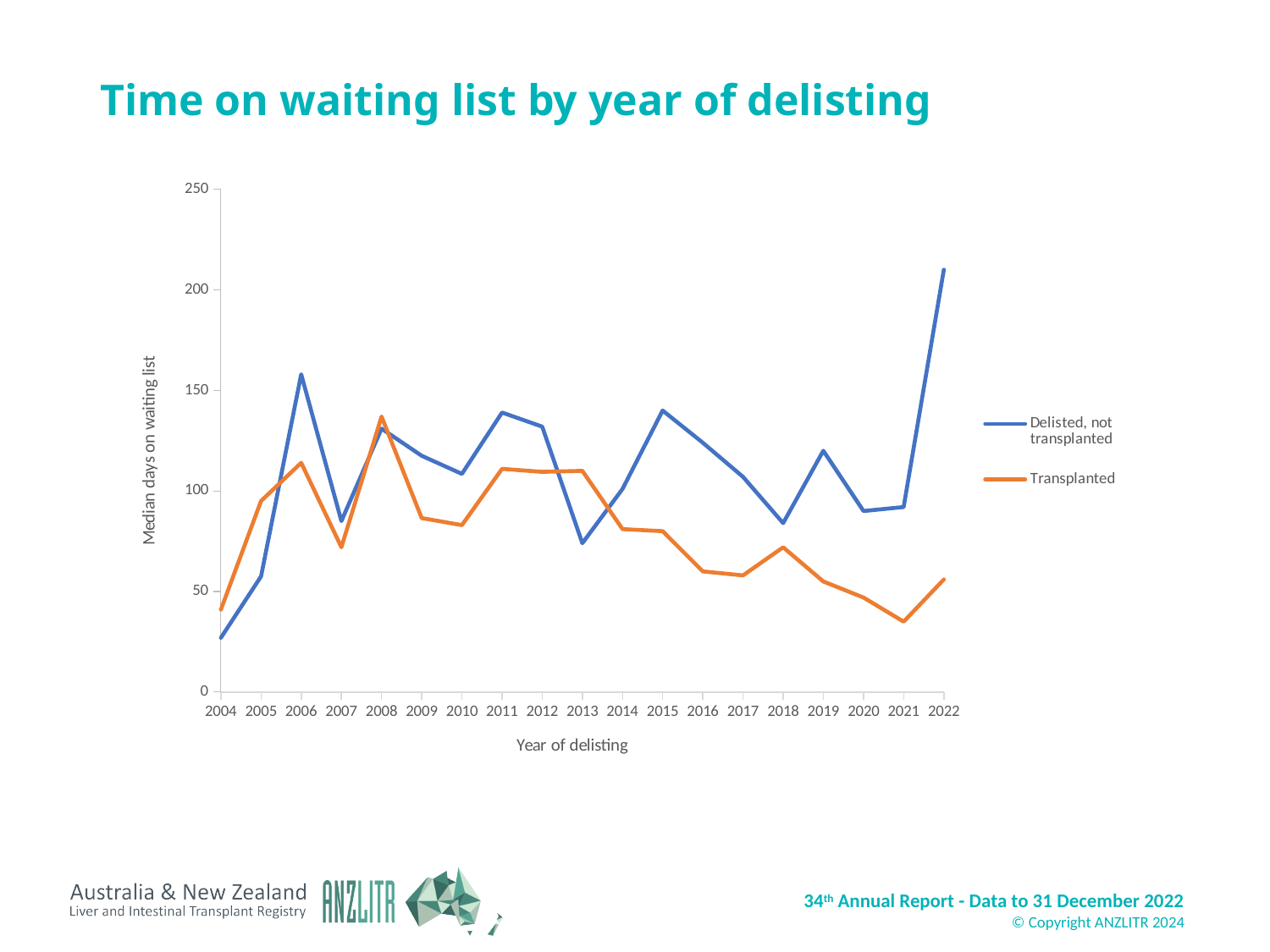
In 2022, which series has the higher median days on waiting list? Delisted, not transplanted What is the label of the y axis? Median days on waiting list In 2005, which series has the higher median days on waiting list? Transplanted Is the value for 'Transplanted' in 2021 greater or less than 50? less Is the value for 'Delisted, not transplanted' in 2022 greater or less than 200? greater In which year is the 'Delisted, not transplanted' series at its highest? 2022 In which year is the 'Transplanted' series at its lowest? 2021 How many years are plotted along the x axis? 19 In which year is the 'Delisted, not transplanted' series at its lowest? 2004 In which year is the 'Transplanted' series at its highest? 2008 How many series does the legend list? 2 What kind of chart is shown on the slide? Line chart